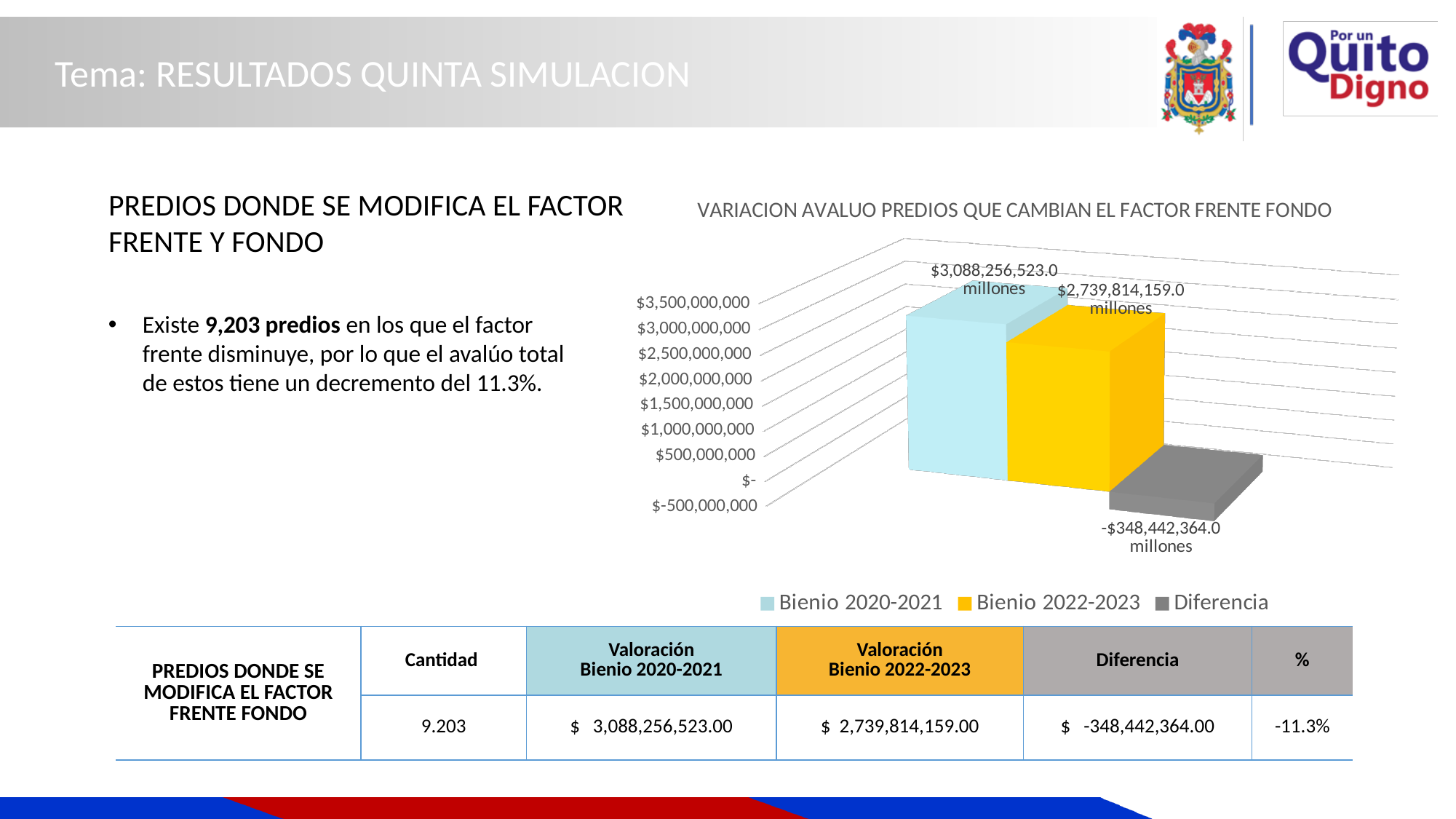
What type of chart is shown on the slide? bar chart What is the value shown for Bienio 2022-2023 in the chart? $2,739,814,159.0 millones Which series has the highest value in the chart? Bienio 2020-2021 Which series has the lowest value in the chart? Diferencia How many series does the chart legend list? 3 Is the value for Bienio 2020-2021 greater or less than $3,000,000,000? greater Is the value for Bienio 2022-2023 greater or less than $3,000,000,000? less What is the title of the chart? VARIACION AVALUO PREDIOS QUE CAMBIAN EL FACTOR FRENTE FONDO What is the value shown for Diferencia in the chart? -$348,442,364.0 millones What colour is the bar for Diferencia in the chart? grey Which is larger in the chart, Bienio 2020-2021 or Bienio 2022-2023? Bienio 2020-2021 What is the value shown for Bienio 2020-2021 in the chart? $3,088,256,523.0 millones